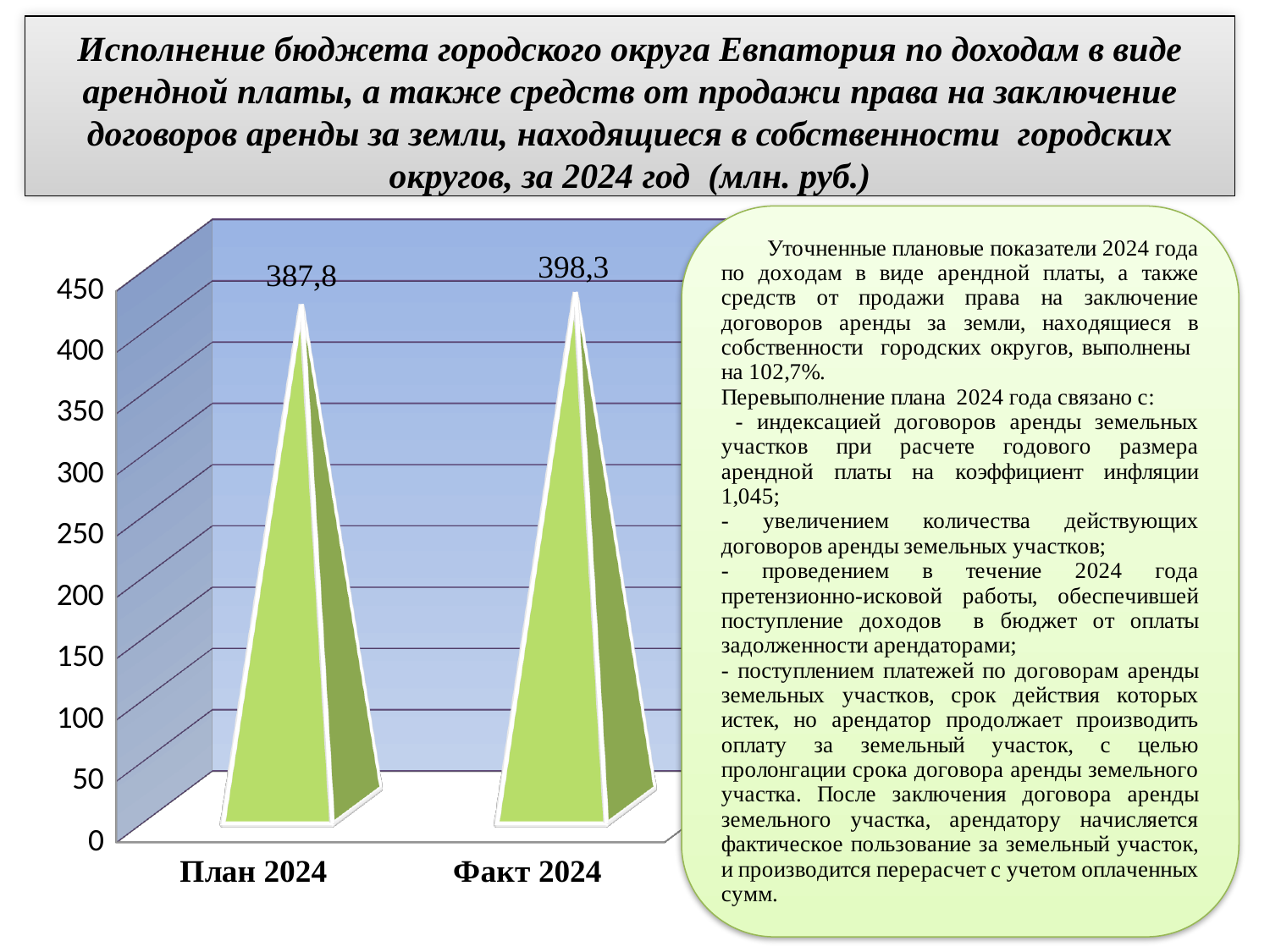
How many categories are shown on the chart? 2 Is the value for План 2024 greater or less than 350? greater Which category has the higher value, План 2024 or Факт 2024? Факт 2024 Is the value for Факт 2024 larger than the value for План 2024? Yes What is the difference between the values for Факт 2024 and План 2024? 10,5 What is the value for План 2024? 387,8 Which category has the lower value? План 2024 What is the value for Факт 2024? 398,3 What is the highest value shown on the vertical axis of the chart? 450 What kind of chart is shown on the slide? Bar chart Do the values rise or fall from План 2024 to Факт 2024? Rise